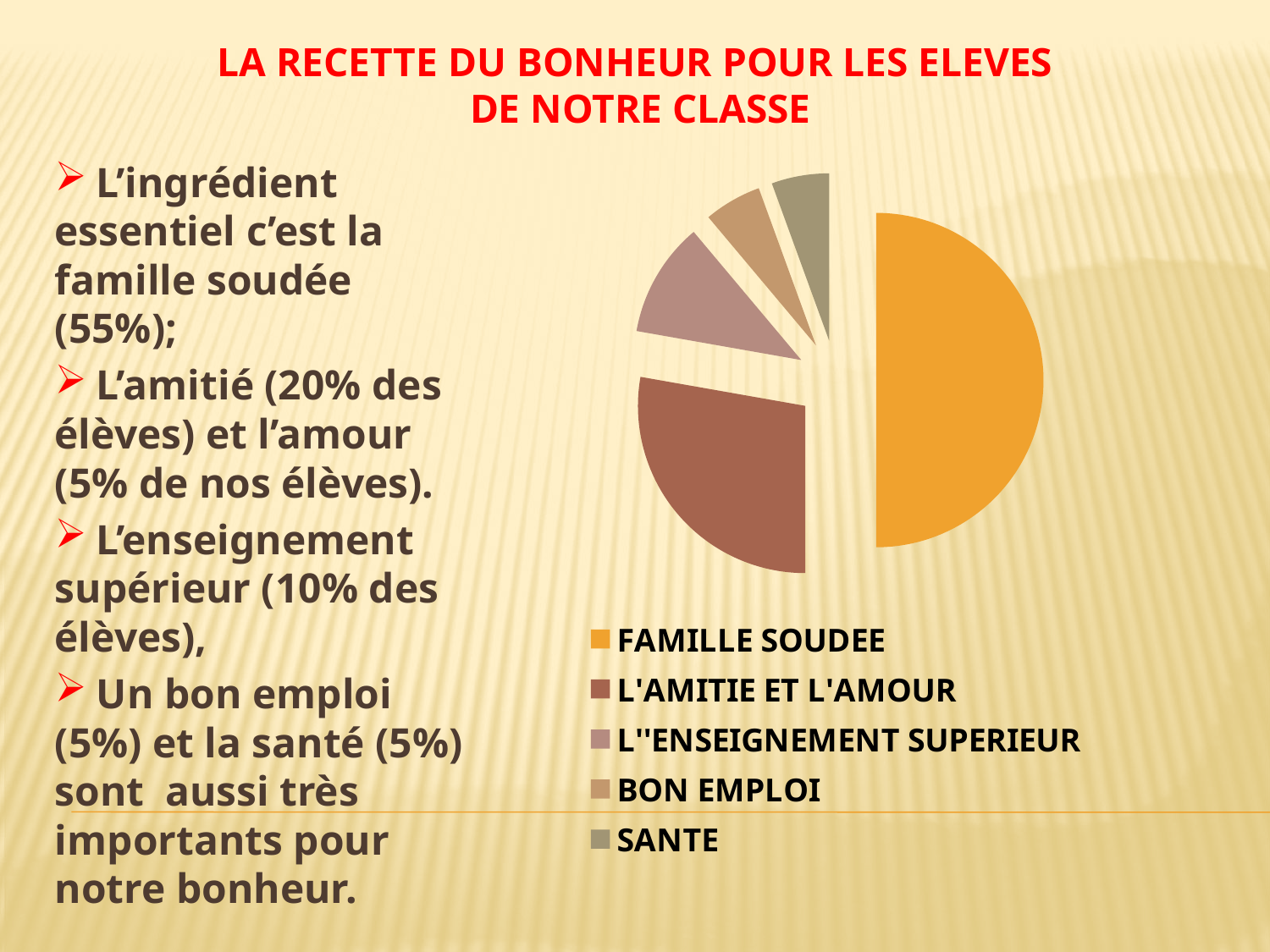
Which category is the second-largest slice in the pie chart? L'AMITIE ET L'AMOUR How many entries does the legend of the pie chart list? 5 Which legend entry is listed first below the pie chart? FAMILLE SOUDEE What colour is the FAMILLE SOUDEE slice in the pie chart? orange Which category has the largest slice in the pie chart? FAMILLE SOUDEE Which slice is larger in the pie chart, L''ENSEIGNEMENT SUPERIEUR or SANTE? L''ENSEIGNEMENT SUPERIEUR Which slice is larger in the pie chart, FAMILLE SOUDEE or L'AMITIE ET L'AMOUR? FAMILLE SOUDEE How many slices does the pie chart have? 5 What kind of chart is shown on the slide? pie chart